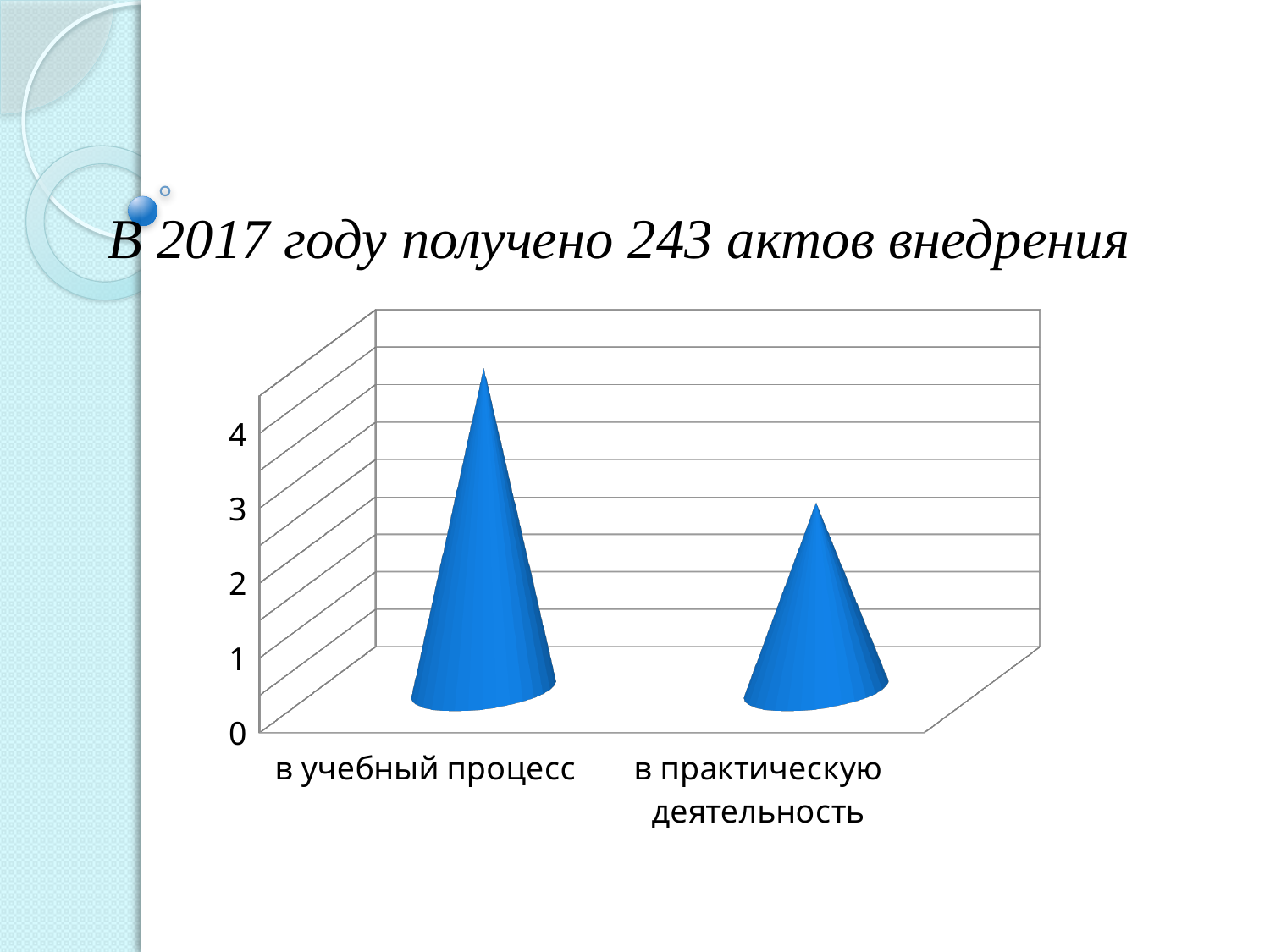
Which is larger: the value for "в учебный процесс" or the value for "в практическую деятельность"? в учебный процесс Which category has the lowest value in the chart? в практическую деятельность What is the title of the chart on the slide? В 2017 году получено 243 актов внедрения What colour are the bars in the chart? blue What kind of chart is shown on the slide? bar chart Is the value for "в практическую деятельность" greater or less than 4? less Which category has the highest value in the chart? в учебный процесс How many categories are shown on the x axis of the chart? 2 What is the highest tick value labelled on the vertical axis of the chart? 4 Is the value for "в учебный процесс" greater or less than 3? greater Is the value for "в практическую деятельность" greater or less than 1? greater Do the values rise or fall from left to right along the x axis? fall